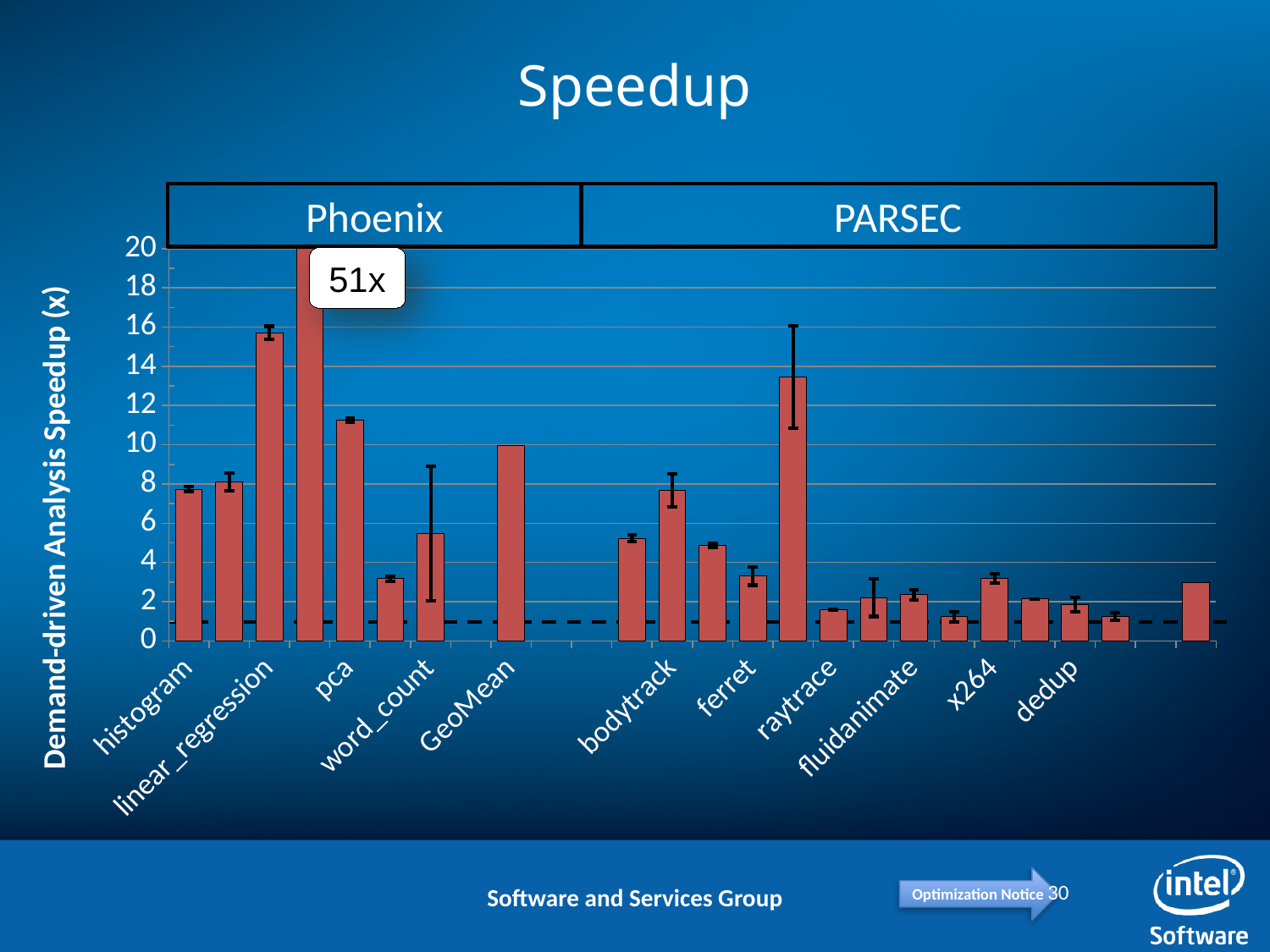
What kind of chart is shown on the slide? bar chart What is the label on the y axis of the chart? Demand-driven Analysis Speedup (x) What value is annotated on the bar that extends beyond the top of the y axis? 51x Which benchmark group, Phoenix or PARSEC, contains more bars? PARSEC Is the value for histogram greater or less than 10? less What is the title of the chart? Speedup Which benchmark group contains the bar annotated 51x? Phoenix At what y-axis value is the horizontal dashed line drawn? 1 Is the value for GeoMean in the Phoenix group greater or less than 8? greater Is the value for GeoMean in the Phoenix group greater or less than 12? less What is the highest value shown on the y axis? 20